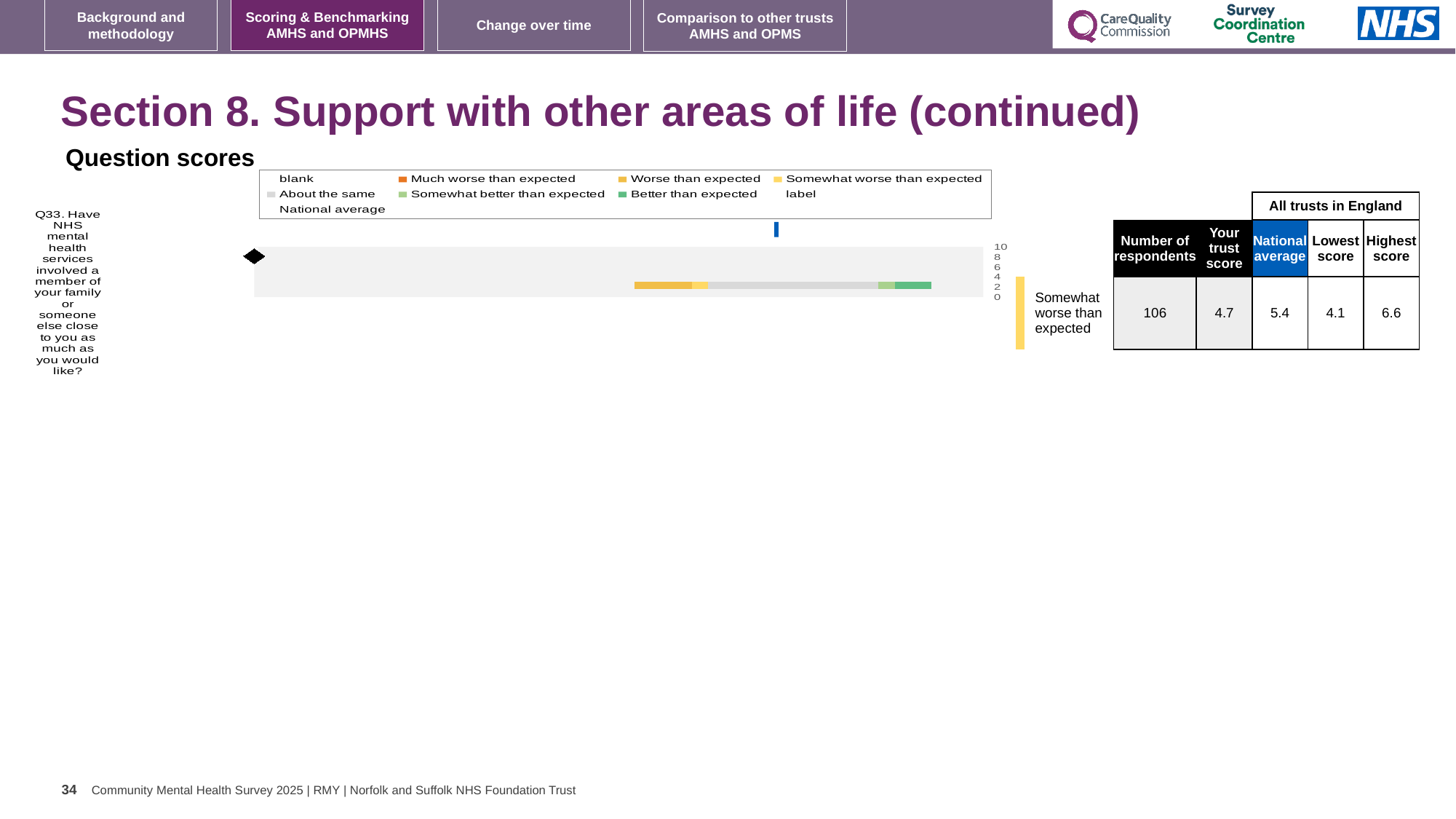
In the table beside the chart, what is the lowest score among all trusts in England for Q33? 4.1 How many questions (categories) are plotted in the chart? 1 What benchmark category label is shown to the right of the chart for Q33? Somewhat worse than expected What kind of chart is shown under 'Question scores'? bar chart What is the difference between the highest score and the lowest score for Q33 in the table? 2.5 Which question is plotted in the chart? Q33. Have NHS mental health services involved a member of your family or someone else close to you as much as you would like? In the table beside the chart, what is the highest score among all trusts in England for Q33? 6.6 In the table beside the chart, what is the trust's score for Q33? 4.7 In the table beside the chart, what is the number of respondents for Q33? 106 In the table beside the chart, what is the national average for Q33? 5.4 How many entries does the chart legend list? 9 Is the trust's score for Q33 higher or lower than the national average? lower